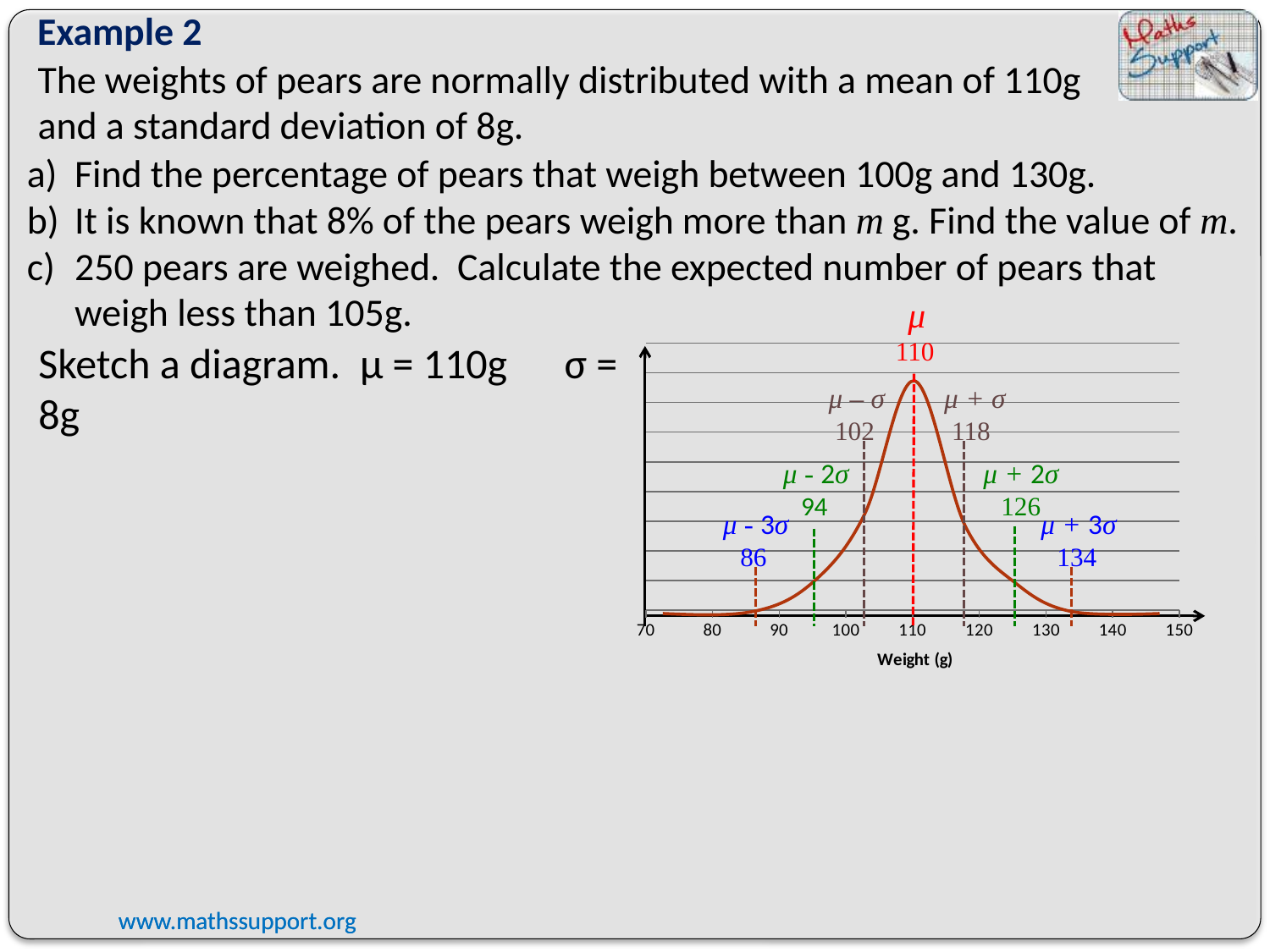
At which labelled weight does the curve reach its highest point? 110 What is the lowest value shown on the x-axis of the chart? 70 What value is labelled at μ – σ on the chart? 102 What is the x-axis title of the chart? Weight (g) What is the difference between the values labelled at μ + 3σ and μ - 3σ? 48 Is the curve higher at a weight of 110 or at a weight of 94? 110 How many vertical dashed lines are drawn on the chart? 7 What value is labelled at μ + 2σ on the chart? 126 What value is labelled at μ on the chart? 110 What value is labelled at μ + 3σ on the chart? 134 What value is labelled at μ + σ on the chart? 118 What value is labelled at μ - 3σ on the chart? 86